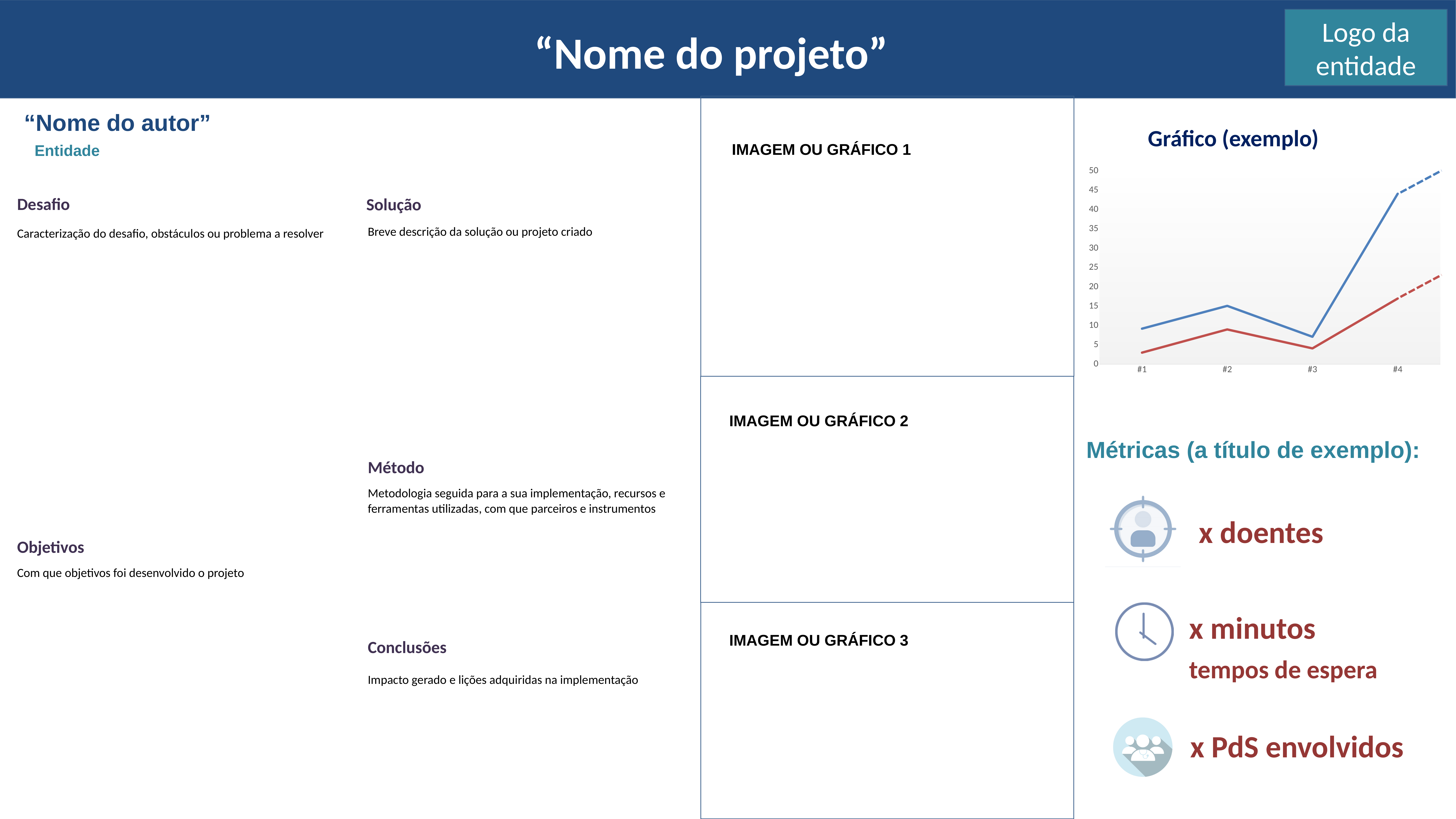
In the "Gráfico (exemplo)" chart, is the value of the blue line at #4 greater or less than 40? greater What is the title of the chart on the right side of the slide? Gráfico (exemplo) In the "Gráfico (exemplo)" chart, is the value of the blue line at #3 greater or less than 10? less In the "Gráfico (exemplo)" chart, do the lines rise or fall from #3 to #4? rise In the "Gráfico (exemplo)" chart, which line has the larger value at #2, the blue line or the red line? the blue line What kind of chart is shown under the title "Gráfico (exemplo)"? line chart What is the highest value shown on the y axis of the "Gráfico (exemplo)" chart? 50 In the "Gráfico (exemplo)" chart, at which category does the red line reach its highest value? #4 In the "Gráfico (exemplo)" chart, is the value of the red line at #1 greater or less than 5? less How many lines are plotted in the "Gráfico (exemplo)" chart? 2 In the "Gráfico (exemplo)" chart, at which category does the blue line reach its highest value? #4 How many categories are shown on the x axis of the "Gráfico (exemplo)" chart? 4